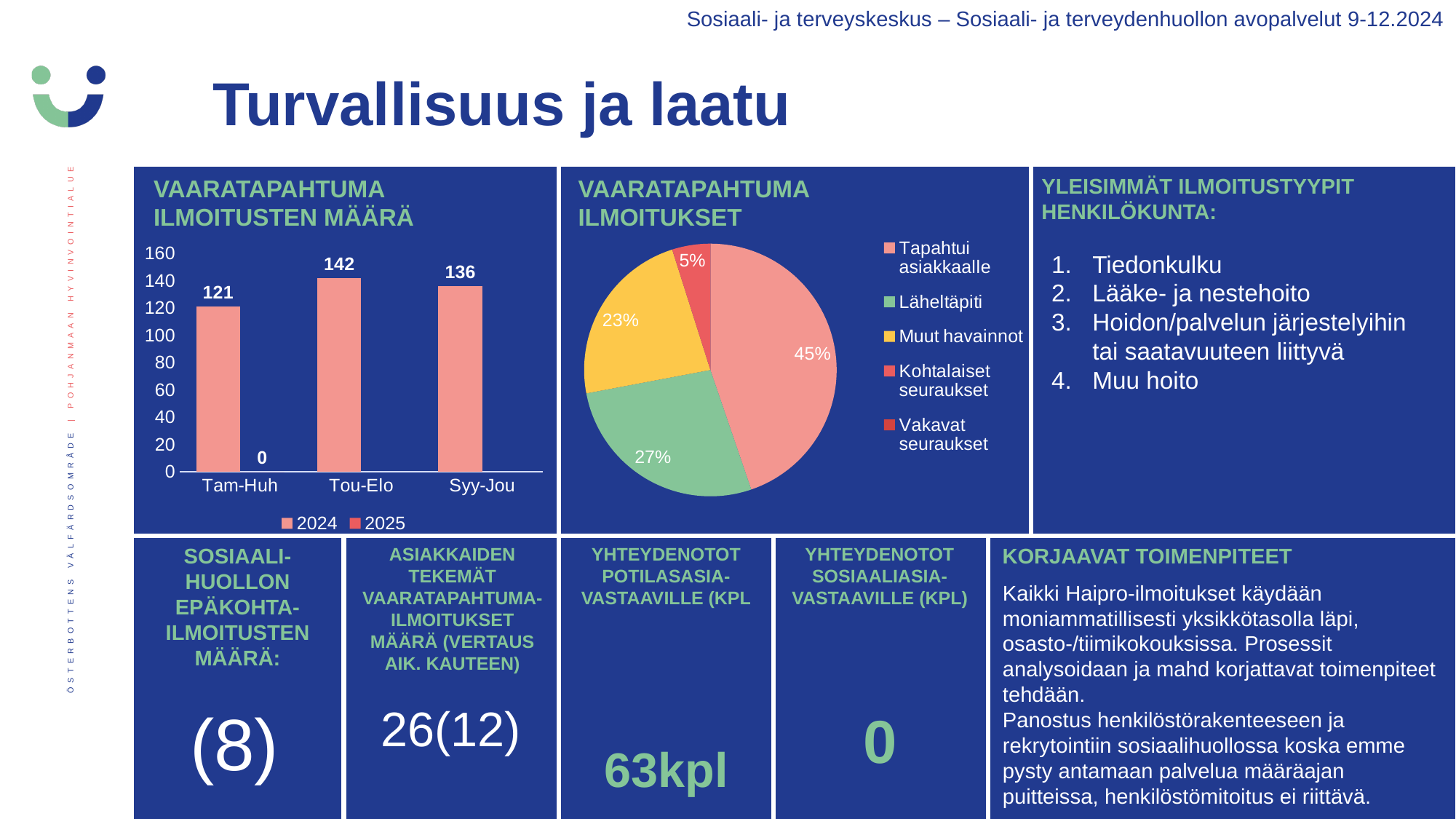
In the bar chart 'VAARATAPAHTUMA ILMOITUSTEN MÄÄRÄ', how many series does the legend list? 2 In the bar chart 'VAARATAPAHTUMA ILMOITUSTEN MÄÄRÄ', which is larger: the 2024 value for Syy-Jou or for Tam-Huh? Syy-Jou What kind of chart is 'VAARATAPAHTUMA ILMOITUKSET'? Pie chart In the pie chart 'VAARATAPAHTUMA ILMOITUKSET', what share does 'Tapahtui asiakkaalle' have? 45% In the pie chart 'VAARATAPAHTUMA ILMOITUKSET', what share does 'Läheltäpiti' have? 27% In the bar chart 'VAARATAPAHTUMA ILMOITUSTEN MÄÄRÄ', what is the 2024 value for Tam-Huh? 121 In the pie chart 'VAARATAPAHTUMA ILMOITUKSET', how many categories does the legend list? 5 In the bar chart 'VAARATAPAHTUMA ILMOITUSTEN MÄÄRÄ', what is the 2024 value for Tou-Elo? 142 In the bar chart 'VAARATAPAHTUMA ILMOITUSTEN MÄÄRÄ', what is the difference between the 2024 values for Tou-Elo and Tam-Huh? 21 In the bar chart 'VAARATAPAHTUMA ILMOITUSTEN MÄÄRÄ', what is the 2024 value for Syy-Jou? 136 In the bar chart 'VAARATAPAHTUMA ILMOITUSTEN MÄÄRÄ', which period has the highest 2024 value? Tou-Elo In the bar chart 'VAARATAPAHTUMA ILMOITUSTEN MÄÄRÄ', what is the 2025 value shown for Tam-Huh? 0